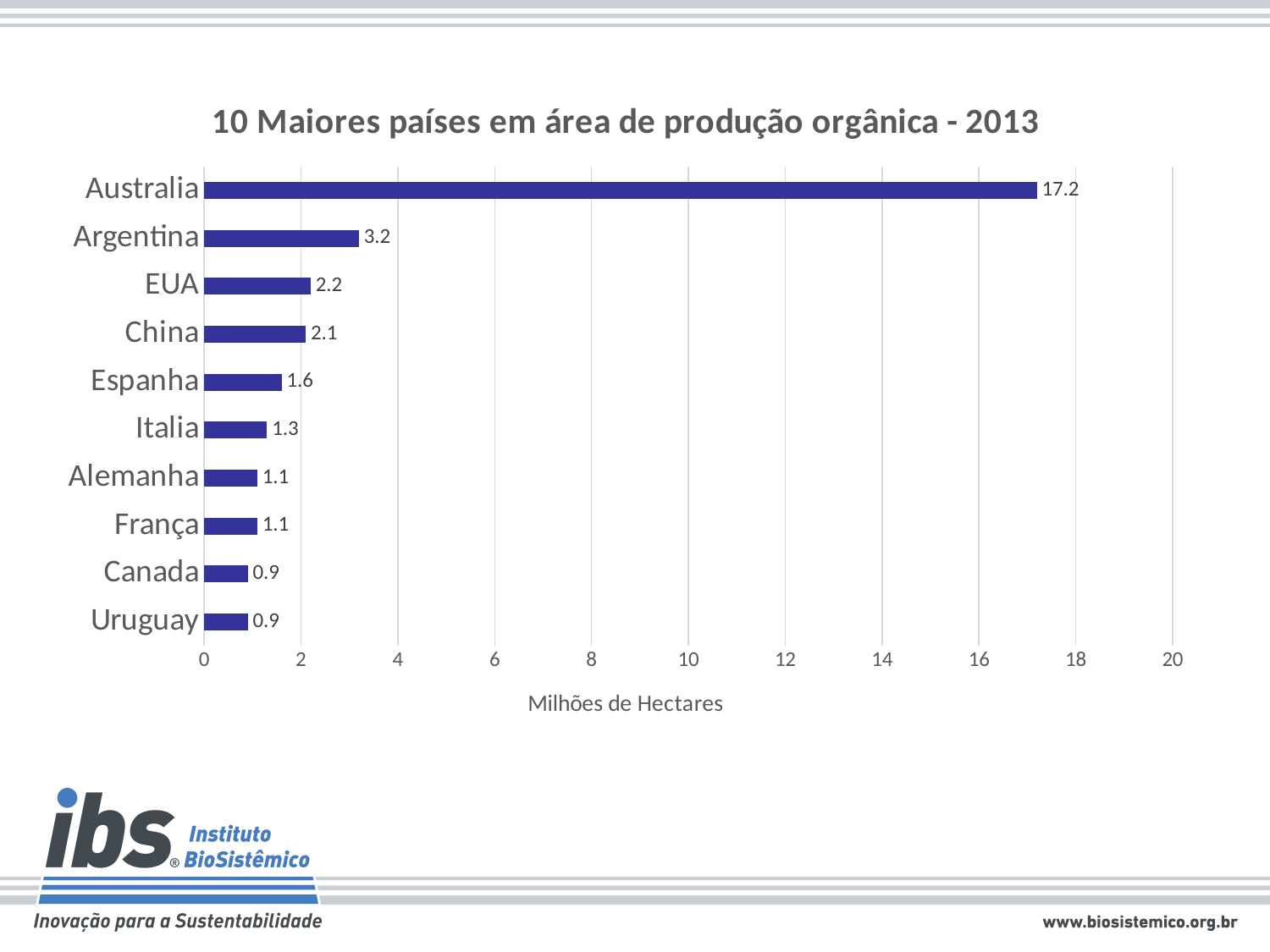
What is the difference between the values for EUA and Espanha? 0.6 What kind of chart is shown on the slide? bar chart Is the value for Australia greater or less than 16? greater What is the difference between the values for Australia and Argentina? 14 What is the value for Italia? 1.3 Which is larger, the value for Argentina or the value for EUA? Argentina What is the value for Australia? 17.2 What is the value for China? 2.1 What is the label of the horizontal axis? Milhões de Hectares Which country has the highest value? Australia What is the value for Argentina? 3.2 How many countries are shown in the chart? 10